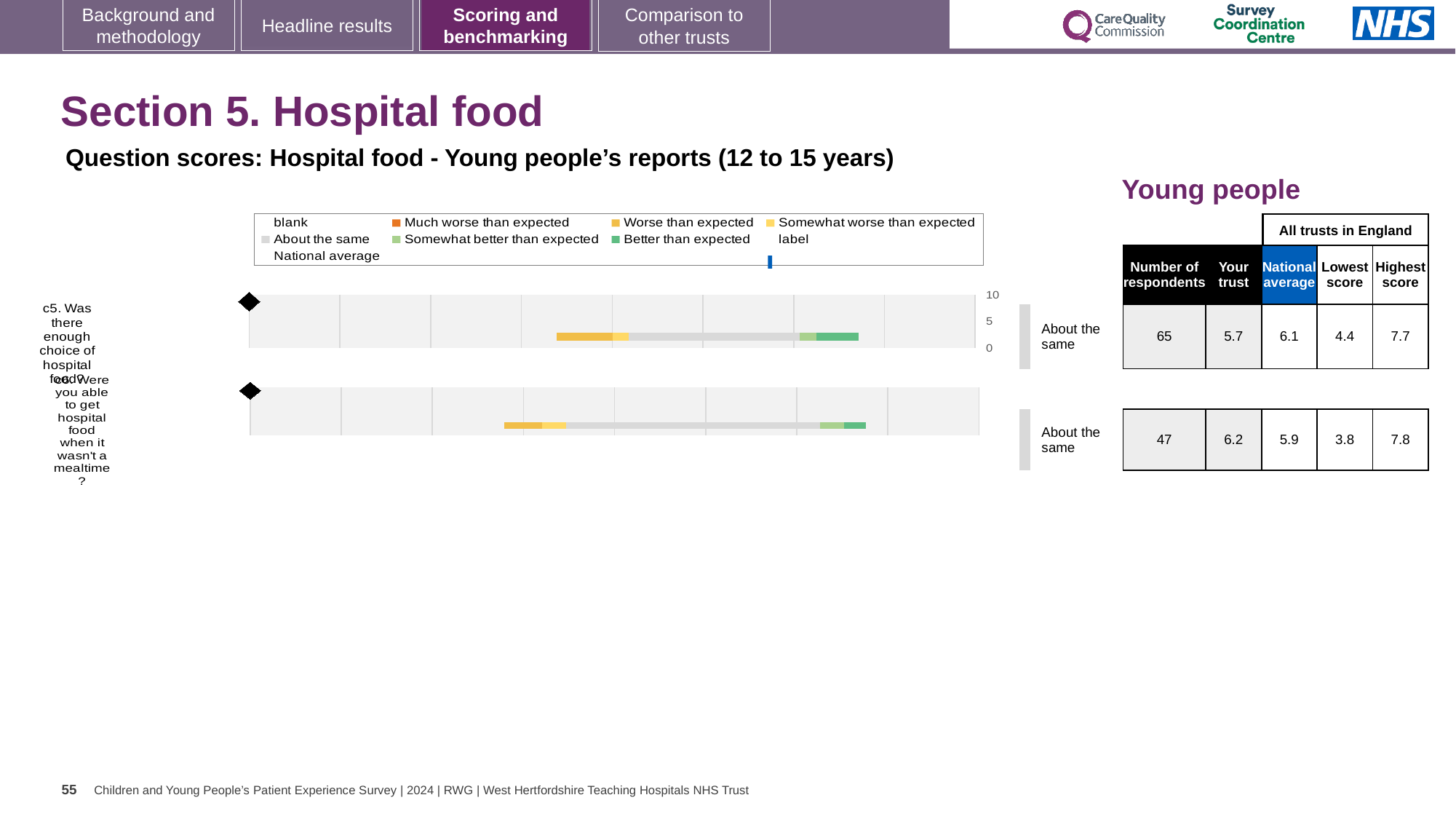
How many questions are plotted in the hospital food chart? 2 What is the 'Your trust' score for question c5 (Was there enough choice of hospital food?)? 5.7 Which legend entry is shown in dark green? Better than expected Which question has more respondents, c5 or c6? c5 What benchmark category is shown next to the chart for question c5? About the same What kind of chart is used to show the question scores for hospital food? bar chart What is the difference between the highest score and the lowest score for question c5? 3.3 What is the 'Your trust' score for question c6 (Were you able to get hospital food when it wasn't a mealtime?)? 6.2 What is the national average score for question c6? 5.9 Which question has the higher 'Your trust' score, c5 or c6? c6 By how much does the 'Your trust' score for c6 exceed the national average for c6? 0.3 How many respondents answered question c5? 65